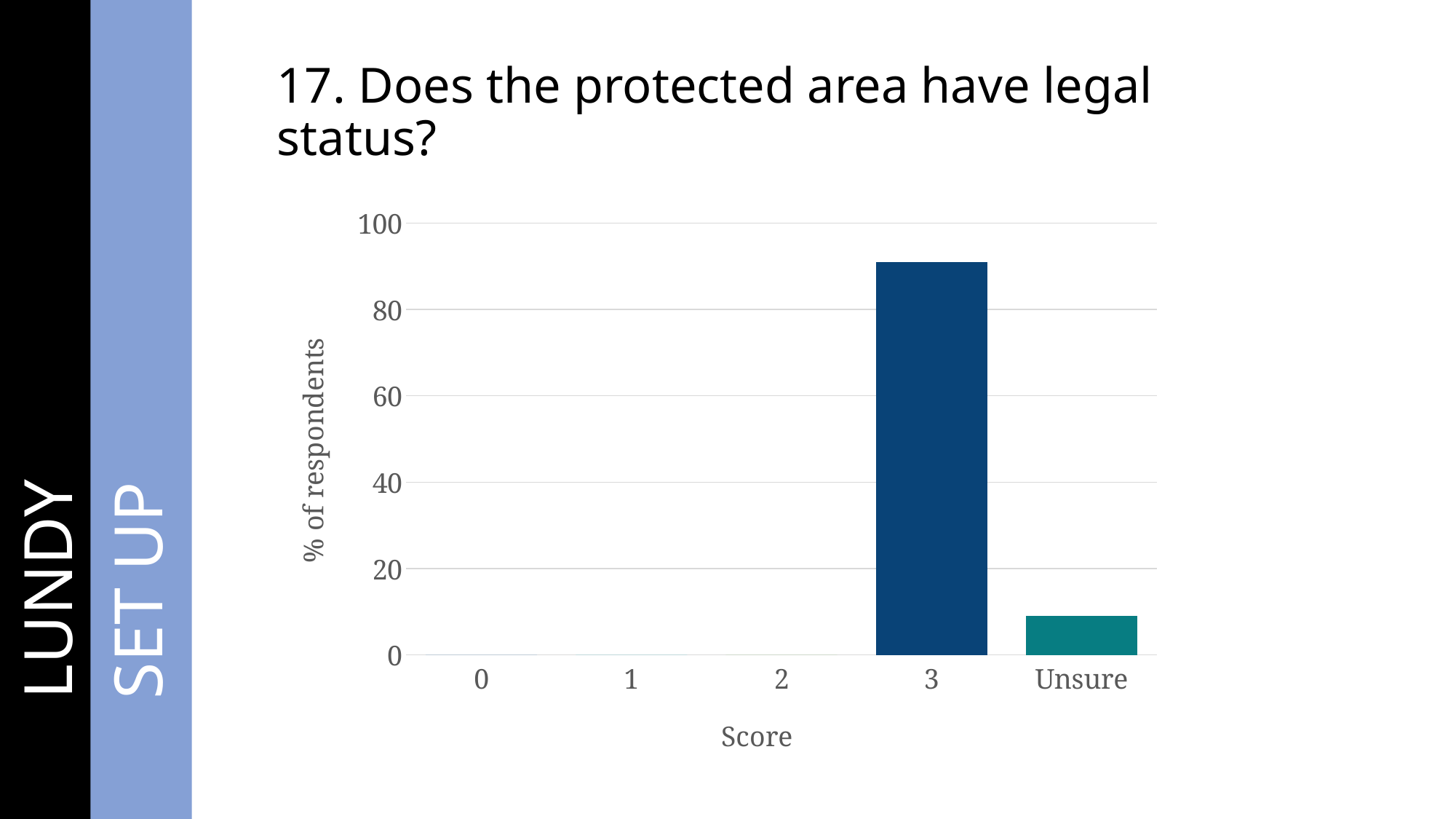
What kind of chart is shown on the slide? bar chart How many score categories are shown on the x axis? 5 Is the value for Unsure greater or less than 20? less How many score categories have a visible bar above zero? 2 Is the value for score 3 greater or less than 100? less What is the label of the vertical axis? % of respondents Is the value for score 3 greater or less than 80? greater Which has a larger percentage of respondents, score 3 or Unsure? 3 What is the label of the horizontal axis? Score Which score category has the highest percentage of respondents? 3